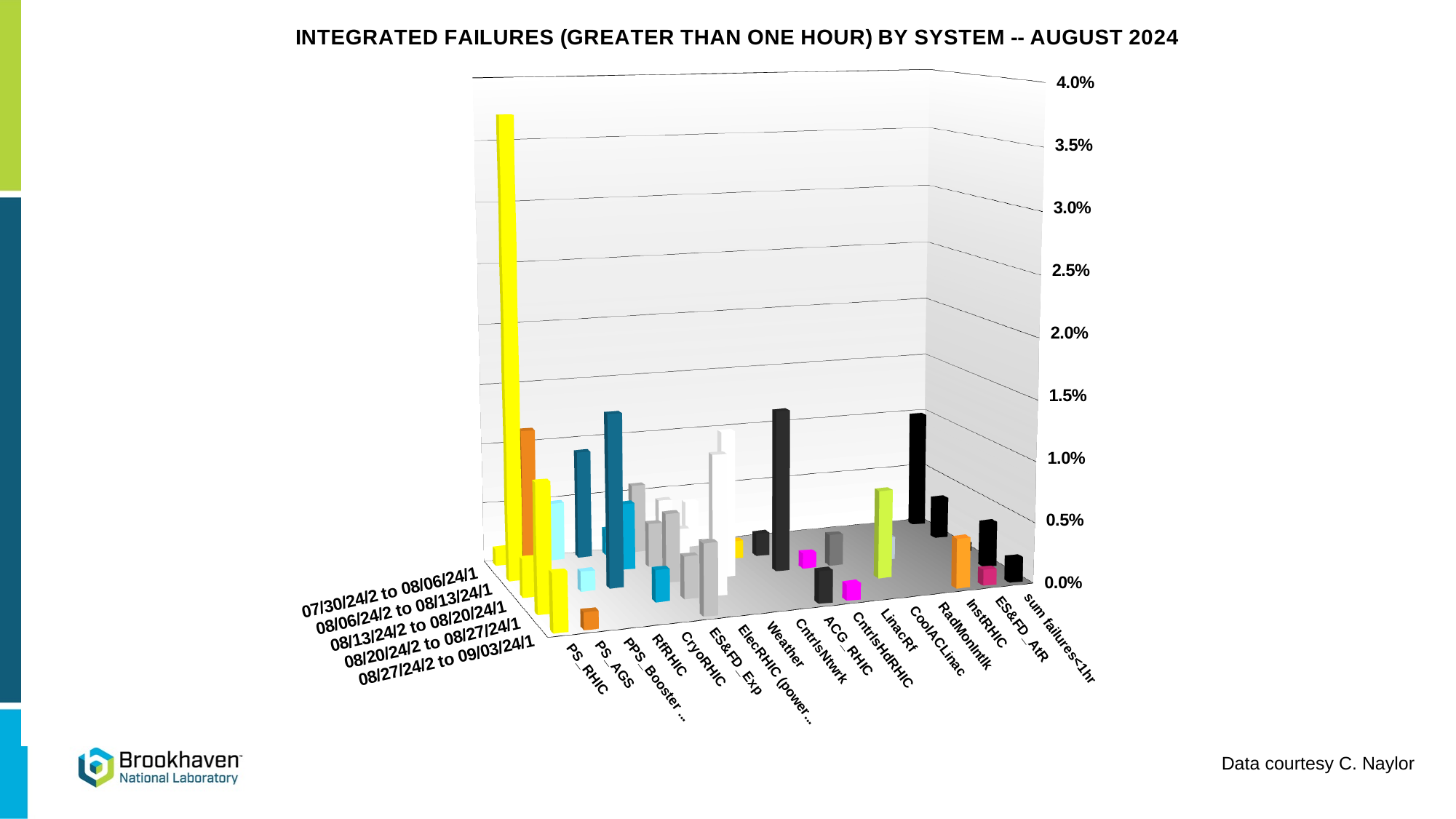
Which system is listed first on the category axis? PS_RHIC How many weekly date ranges are plotted in the chart? 5 Which date range is listed last on the depth axis of the chart? 08/27/24/2 to 09/03/24/1 Which category is listed last on the category axis? sum failures<1hr What kind of chart is shown on the slide? bar chart How many systems are listed along the category axis of the chart? 17 Which system has the tallest bar in the chart? PS_RHIC What is the highest value shown on the vertical axis of the chart? 4.0% Is the tallest bar for PS_RHIC greater or less than 4.0%? less Is the tallest bar for PS_RHIC greater or less than 3.0%? greater Which date range is listed first on the depth axis of the chart? 07/30/24/2 to 08/06/24/1 What is the title of the chart? INTEGRATED FAILURES (GREATER THAN ONE HOUR) BY SYSTEM -- AUGUST 2024